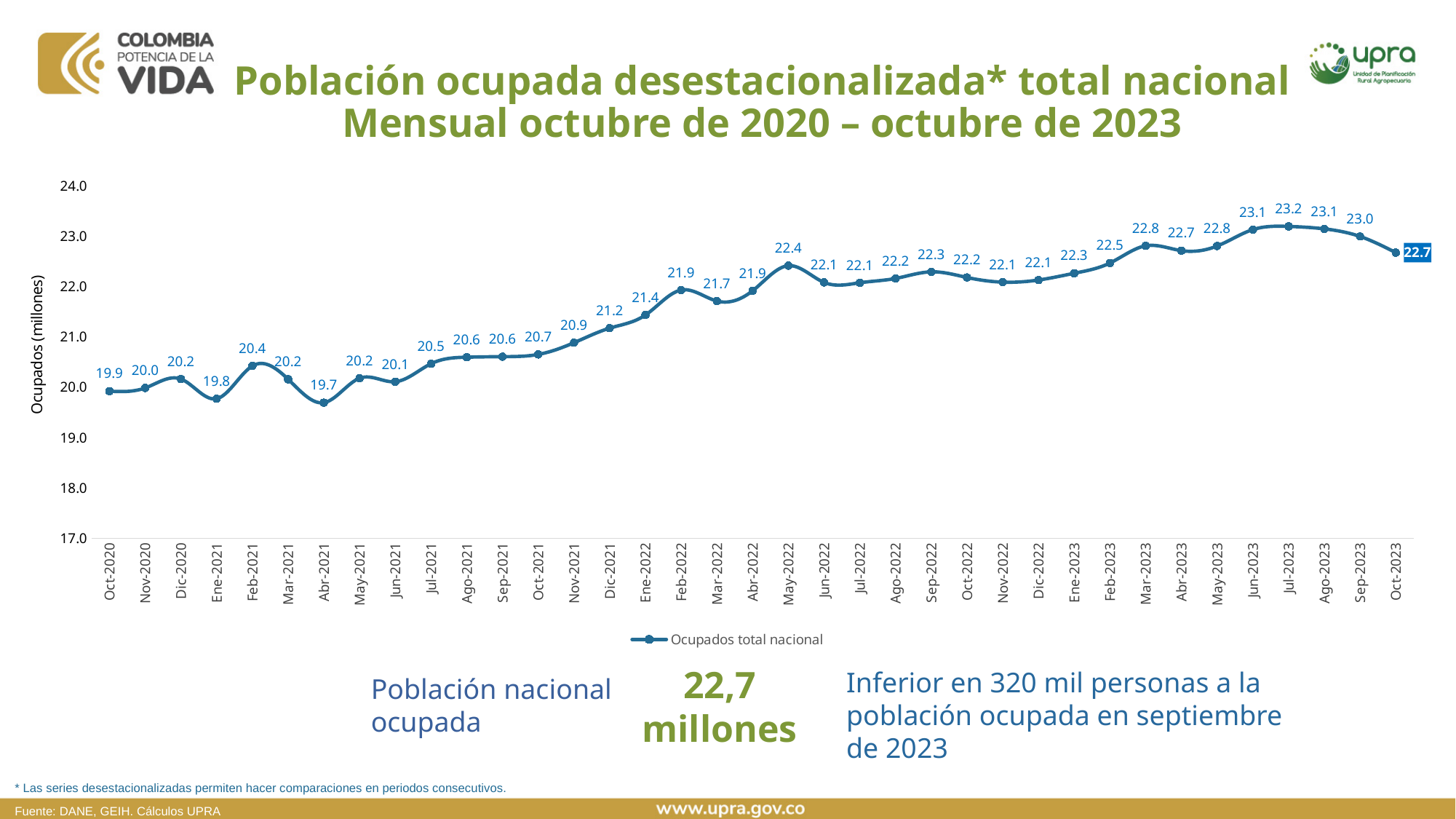
What kind of chart is shown? line chart What is the label of the y axis? Ocupados (millones) Which is larger, the value for Feb-2022 or the value for Mar-2022? Feb-2022 What is the difference between the values for Jul-2023 and Oct-2020? 3.3 What is the value for Oct-2023? 22.7 Which month has the highest value? Jul-2023 How many monthly data points are plotted? 37 What is the value for Abr-2021? 19.7 Which month has the lowest value? Abr-2021 How many series does the legend list? 1 Is the value for Ene-2021 greater or less than 20.0? less What is the value for May-2022? 22.4